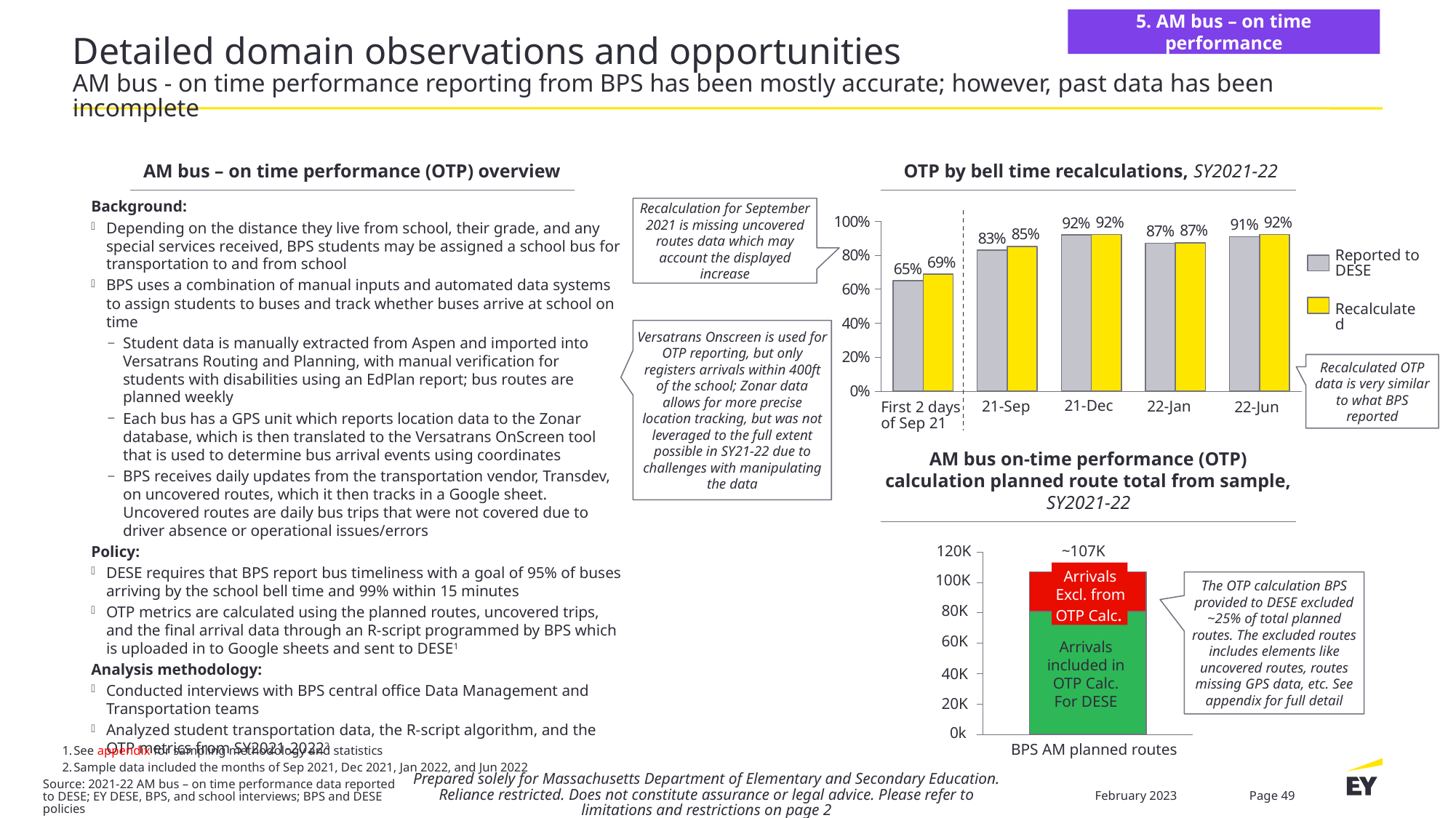
In the 'OTP by bell time recalculations, SY2021-22' chart, which period has the highest Reported to DESE value? 21-Dec What kind of chart is 'AM bus on-time performance (OTP) calculation planned route total from sample, SY2021-22'? Stacked bar chart In the 'AM bus on-time performance (OTP) calculation planned route total from sample, SY2021-22' chart, is the total height of the BPS AM planned routes bar greater or less than 100K? greater In the 'OTP by bell time recalculations, SY2021-22' chart, what is the Recalculated value for 'First 2 days of Sep 21'? 69% In the 'OTP by bell time recalculations, SY2021-22' chart, what is the Reported to DESE value for 21-Sep? 83% In the 'OTP by bell time recalculations, SY2021-22' chart, which period has the lowest Recalculated value? First 2 days of Sep 21 In the 'OTP by bell time recalculations, SY2021-22' chart, for 22-Jun, which is larger: the Reported to DESE value or the Recalculated value? Recalculated (92%) In the 'OTP by bell time recalculations, SY2021-22' chart, what are the two legend entries? Reported to DESE; Recalculated In the 'OTP by bell time recalculations, SY2021-22' chart, how many time periods are shown on the x axis? 5 In the 'OTP by bell time recalculations, SY2021-22' chart, what is the difference between the Recalculated and Reported to DESE values for 'First 2 days of Sep 21'? 4 percentage points In the 'OTP by bell time recalculations, SY2021-22' chart, how many series does the legend list? 2 What kind of chart is 'OTP by bell time recalculations, SY2021-22'? Bar chart